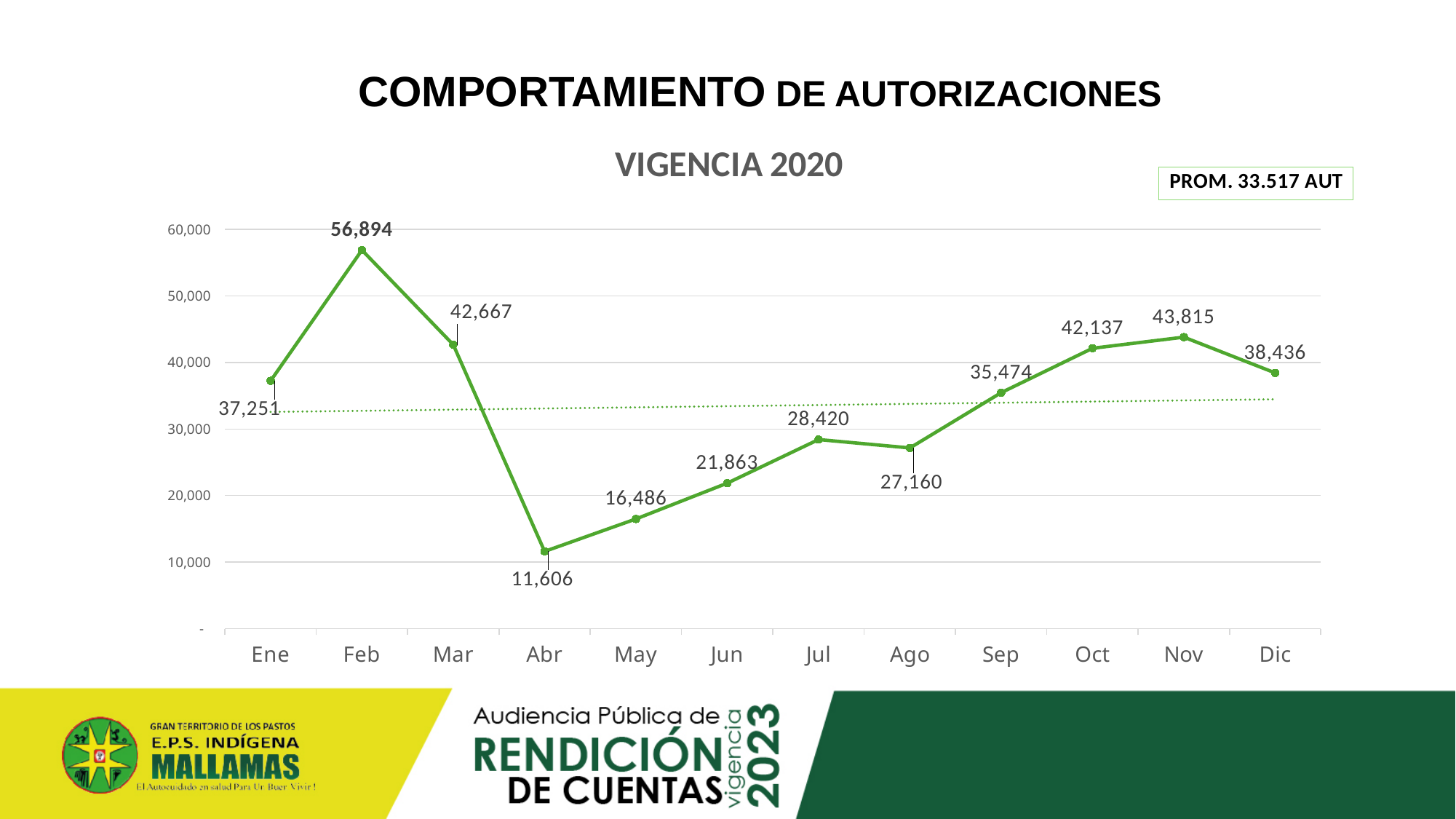
Which month has the highest value? Feb Which month has the lowest value? Abr What is the value for Feb? 56,894 Which is larger, the value for Jul or the value for Ago? Jul What is the value for Sep? 35,474 What is the difference between the values for Feb and Abr? 45,288 What is the value for Abr? 11,606 Do the values rise or fall from Abr to Jul? Rise What is the difference between the values for Nov and Oct? 1,678 What is the title of the chart? VIGENCIA 2020 How many months are plotted on the x axis? 12 What type of chart is shown on the slide? Line chart